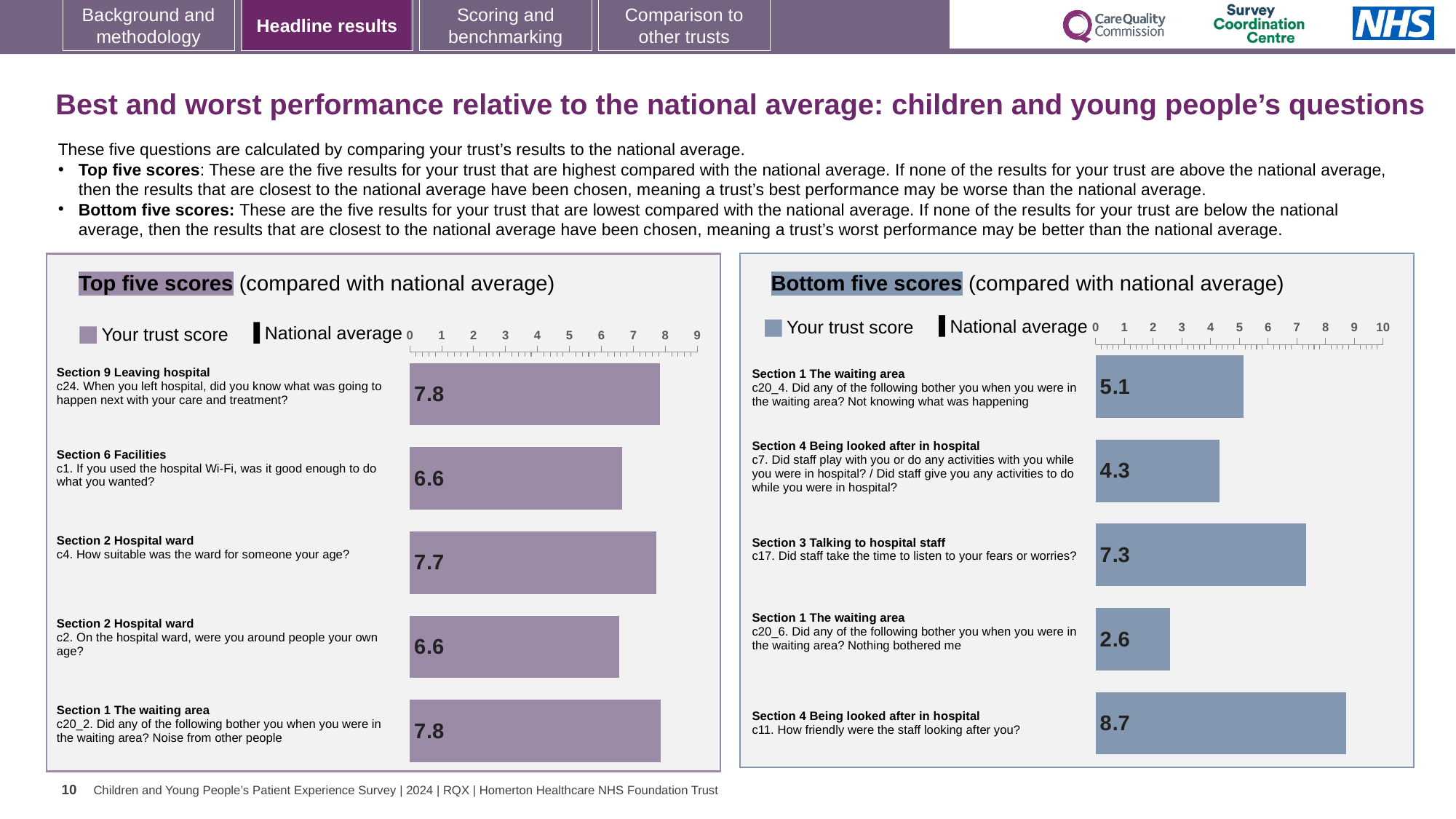
In the Bottom five scores chart, which question has the lowest trust score? c20_6. Nothing bothered me In the Top five scores chart, what is the trust score for c1 about the hospital Wi-Fi? 6.6 In the Top five scores chart, what is the trust score for c4 'How suitable was the ward for someone your age?' 7.7 In the Bottom five scores chart, which has the larger trust score: c20_4 'Not knowing what was happening' or c7 about staff activities? c20_4 'Not knowing what was happening' In the Bottom five scores chart, what is the difference between the trust scores for c11 (8.7) and c20_6 (2.6)? 6.1 In the Bottom five scores chart, what is the trust score for c17 'Did staff take the time to listen to your fears or worries?' 7.3 What type of chart is used in the Bottom five scores panel? Bar chart How many questions are plotted in the Top five scores chart? 5 In the Bottom five scores chart, what is the trust score for c7 about staff playing or doing activities with you? 4.3 In the Top five scores chart, how much higher is the trust score for c24 than for c1? 1.2 What two entries does the legend of the Top five scores chart list? Your trust score and National average In the Bottom five scores chart, which question has the highest trust score? c11. How friendly were the staff looking after you?